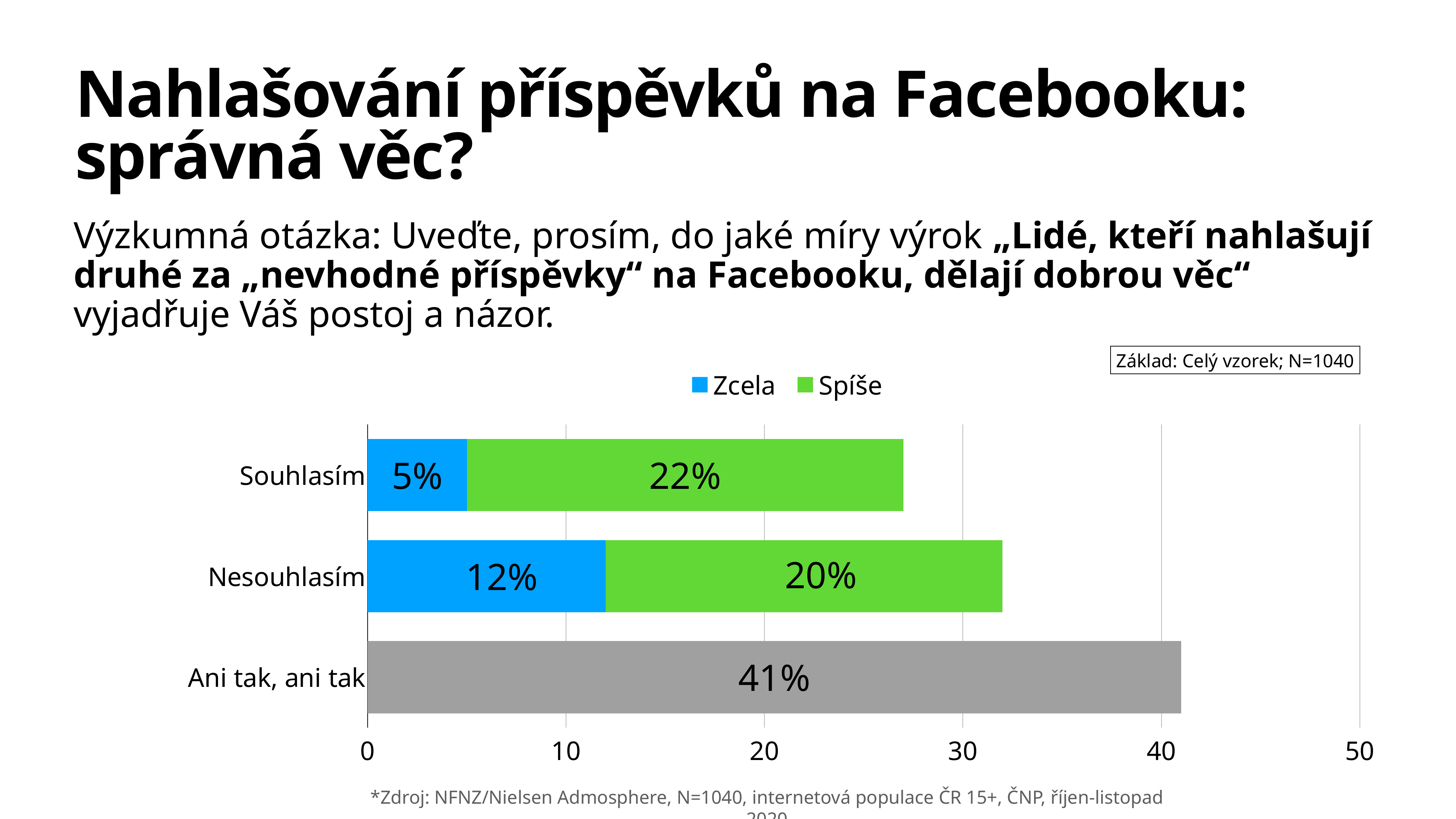
Which is larger: the 'Zcela' value for Souhlasím or for Nesouhlasím? Nesouhlasím What is the total of the stacked bar for Souhlasím? 27% What is the 'Spíše' value for Souhlasím? 22% What is the 'Spíše' value for Nesouhlasím? 20% What is the total of the stacked bar for Nesouhlasím? 32% How many series does the legend list? 2 What kind of chart is shown on the slide? Bar chart What value is shown for 'Ani tak, ani tak'? 41% How many categories are shown on the chart? 3 Which category has the longest bar overall? Ani tak, ani tak What is the 'Zcela' value for Souhlasím? 5% What is the difference between the 'Zcela' values for Nesouhlasím and Souhlasím? 7%